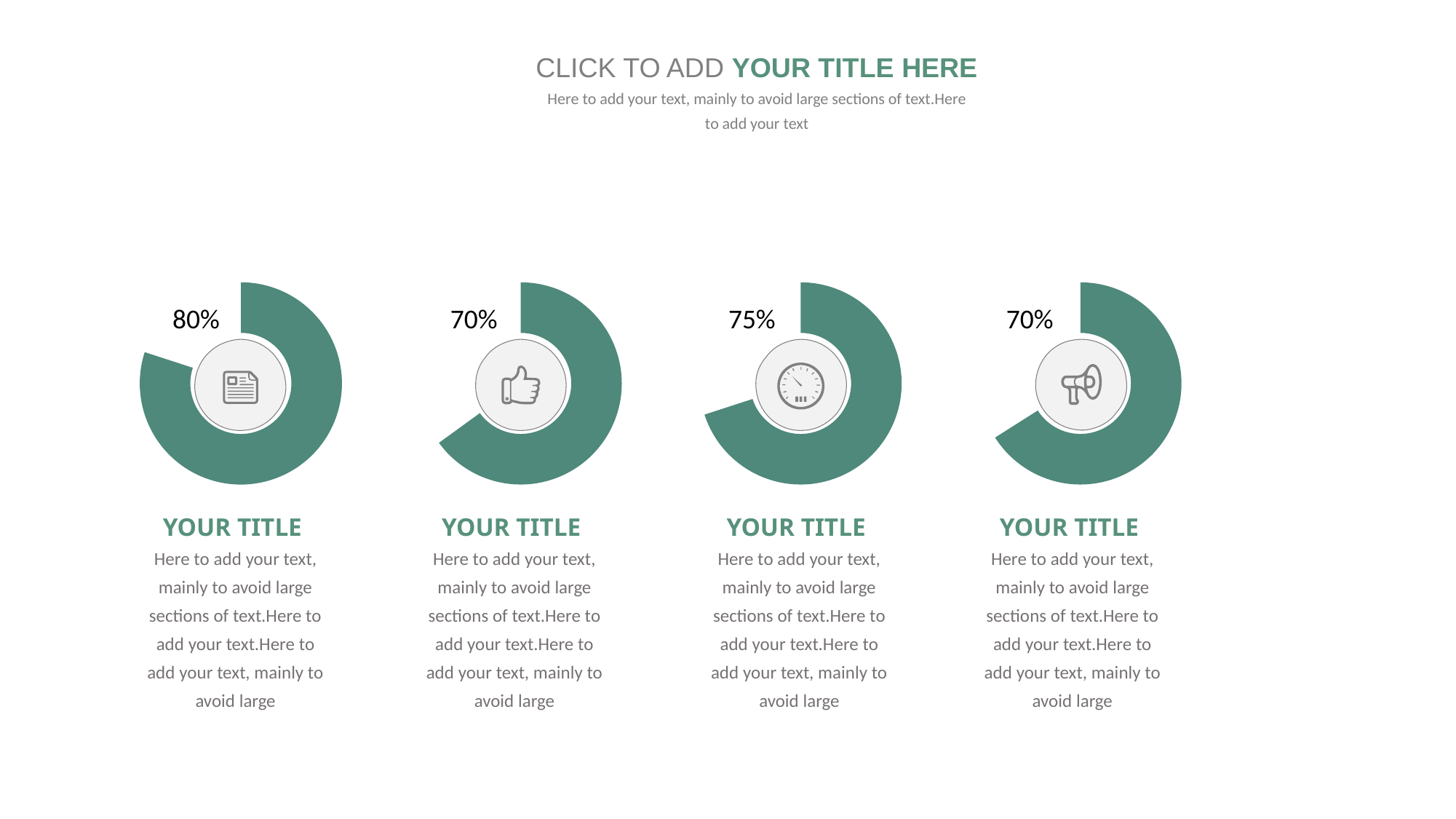
What colour is the filled portion of each chart? Green What percentage is shown on the leftmost chart (with the document icon)? 80% Which charts show the lowest percentage? The second and fourth charts (70%) What is the difference between the percentage on the leftmost chart and the percentage on the third chart? 5% What percentage is shown on the second chart from the left (with the thumbs-up icon)? 70% Which is larger, the percentage on the third chart or the percentage on the second chart? The third chart (75%) What kind of chart is used to display each percentage on the slide? Pie (donut) chart What percentage is shown on the third chart from the left (with the speedometer icon)? 75% How many percentage charts are shown on the slide? 4 What percentage is shown on the rightmost chart (with the megaphone icon)? 70% Which of the four charts shows the highest percentage? The leftmost chart (80%) What is the difference between the percentage on the leftmost chart and the percentage on the rightmost chart? 10%